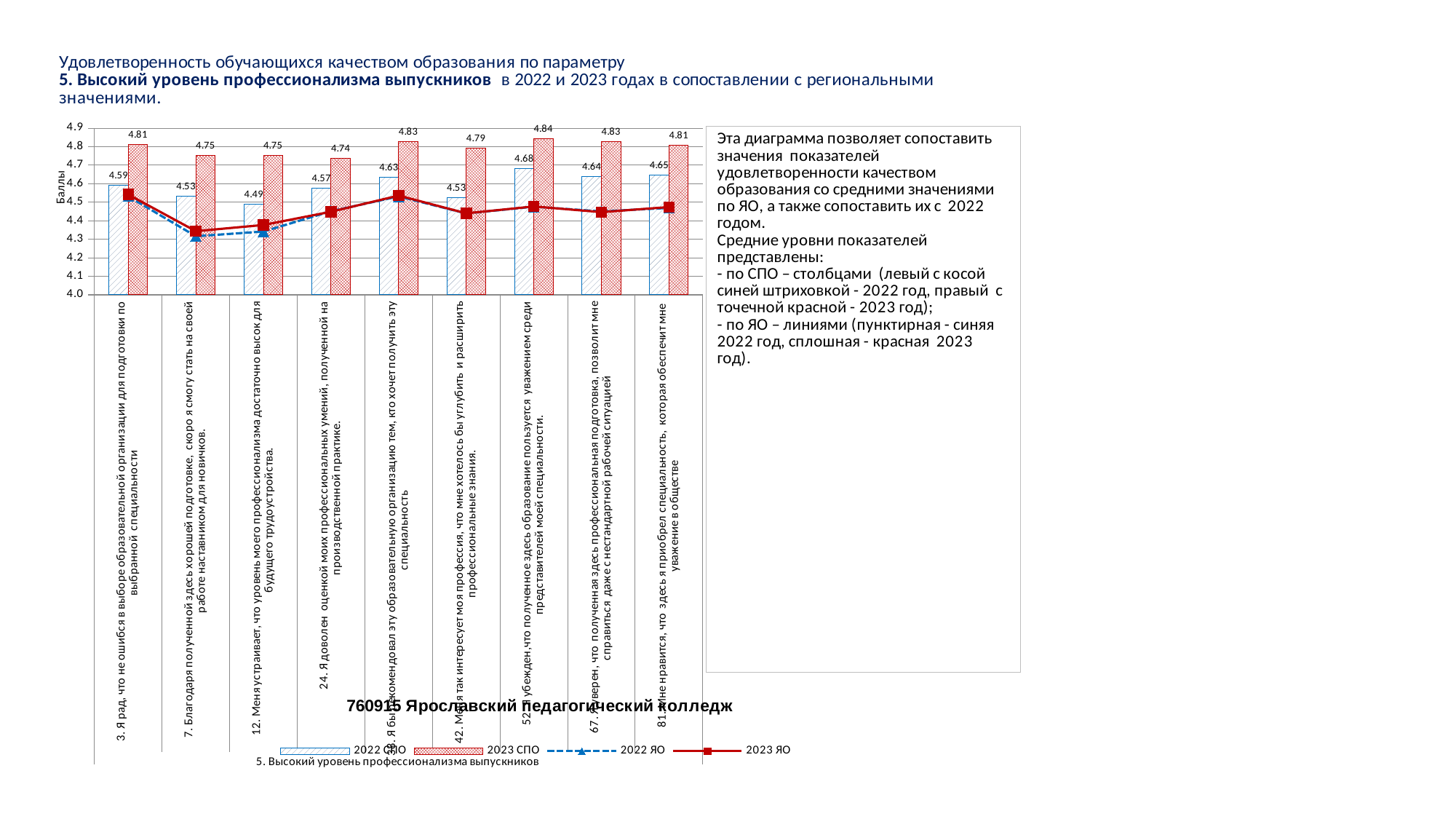
What is the value of the 2022 СПО bar for statement 12 ("Меня устраивает, что уровень моего профессионализма достаточно высок...")? 4.49 Which is larger for statement 24 ("Я доволен оценкой моих профессиональных умений..."): the 2022 СПО value or the 2023 СПО value? 2023 СПО What kind of chart is shown on the slide? Combined bar and line chart How many statements (categories) are shown on the x axis of the chart? 9 Is the 2023 ЯО line value for statement 7 ("Благодаря полученной здесь хорошей подготовке...") greater or less than 4.4? less What is the value of the 2022 СПО bar for statement 3 ("Я рад, что не ошибся в выборе образовательной организации...")? 4.59 Which statement has the lowest 2022 СПО value? 12. Меня устраивает, что уровень моего профессионализма достаточно высок для будущего трудоустройства Which statement has the highest 2023 СПО value? 52. Я убежден, что полученное здесь образование пользуется уважением среди представителей моей специальности What is the difference between the 2023 СПО and 2022 СПО values for statement 42 ("Меня так интересует моя профессия...")? 0.26 What is the label of the vertical axis of the chart? Баллы What is the value of the 2023 СПО bar for statement 52 ("Я убежден, что полученное здесь образование пользуется уважением...")? 4.84 How many series does the chart legend list? 4